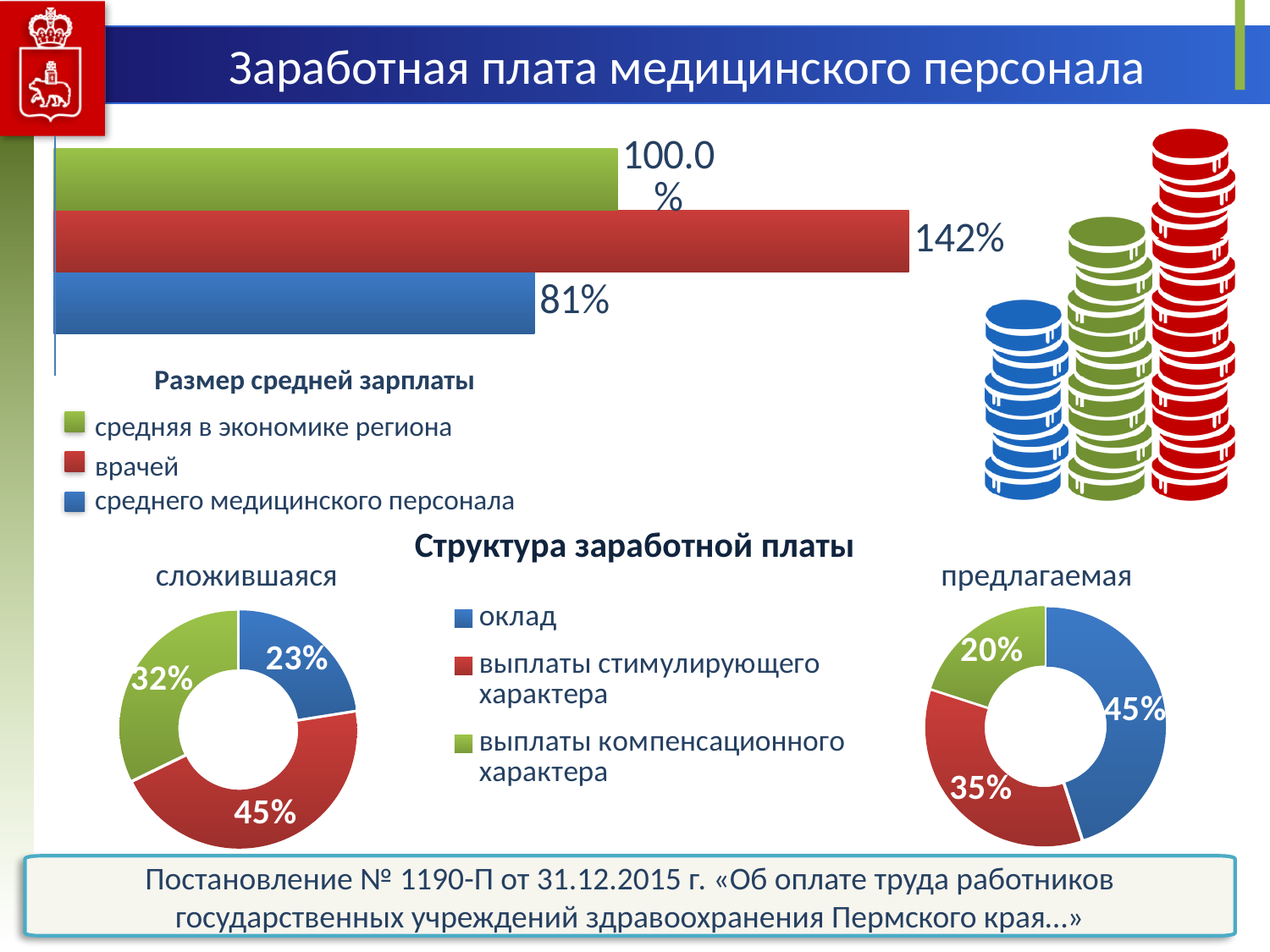
In the 'сложившаяся' donut chart, what share is оклад? 23% In the bar chart 'Размер средней зарплаты', what is the value for врачей? 142% In the bar chart 'Размер средней зарплаты', which category has the lowest value? среднего медицинского персонала In the bar chart 'Размер средней зарплаты', what is the value for среднего медицинского персонала? 81% In the 'предлагаемая' donut chart, what share is оклад? 45% What kind of chart is 'Размер средней зарплаты'? bar chart In the 'сложившаяся' donut chart, what share is выплаты компенсационного характера? 32% In the bar chart 'Размер средней зарплаты', what is the difference between the value for врачей and the value for среднего медицинского персонала? 61% In the bar chart 'Размер средней зарплаты', which category has the highest value? врачей How many series does the legend of the bar chart 'Размер средней зарплаты' list? 3 In the 'предлагаемая' donut chart, which category has the smallest share? выплаты компенсационного характера Which is larger: the share of оклад in the 'сложившаяся' chart or in the 'предлагаемая' chart? предлагаемая